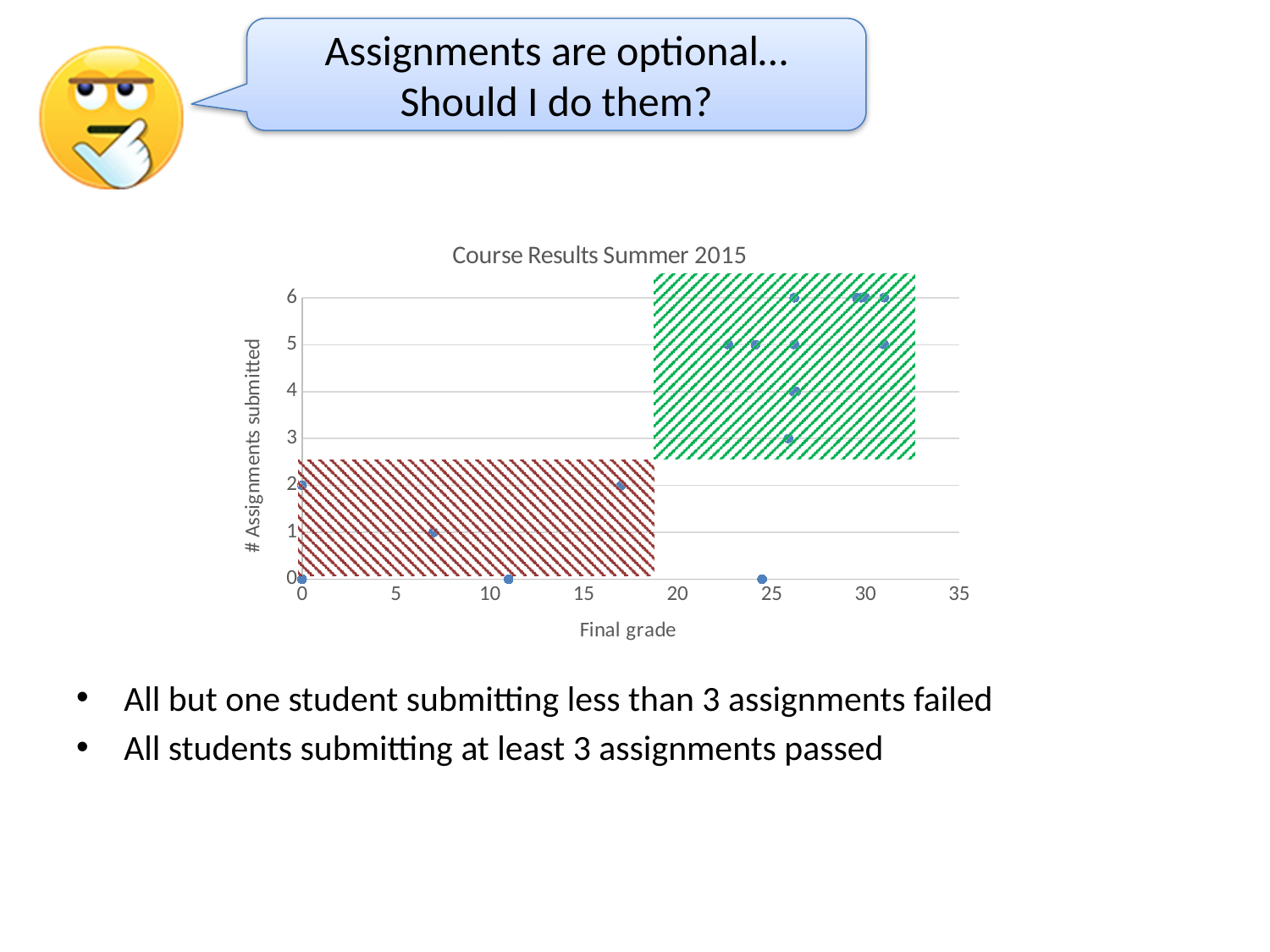
Is the final grade of the student who submitted 3 assignments greater or less than 20? greater What is the title of the chart? Course Results Summer 2015 What is the label of the vertical axis of the chart? # Assignments submitted What is the lowest number of assignments submitted by any student in the chart? 0 Is the final grade of the student who submitted 1 assignment greater or less than 10? less Is the final grade of the student who submitted 4 assignments greater or less than 20? greater What is the highest number of assignments submitted by any student in the chart? 6 Do final grades generally rise or fall as the number of assignments submitted increases? rise Which is larger: the number of assignments submitted by the student with the highest final grade, or by the student with a final grade of 0 and the most assignments? the student with the highest final grade What kind of chart is shown on the slide? scatter chart